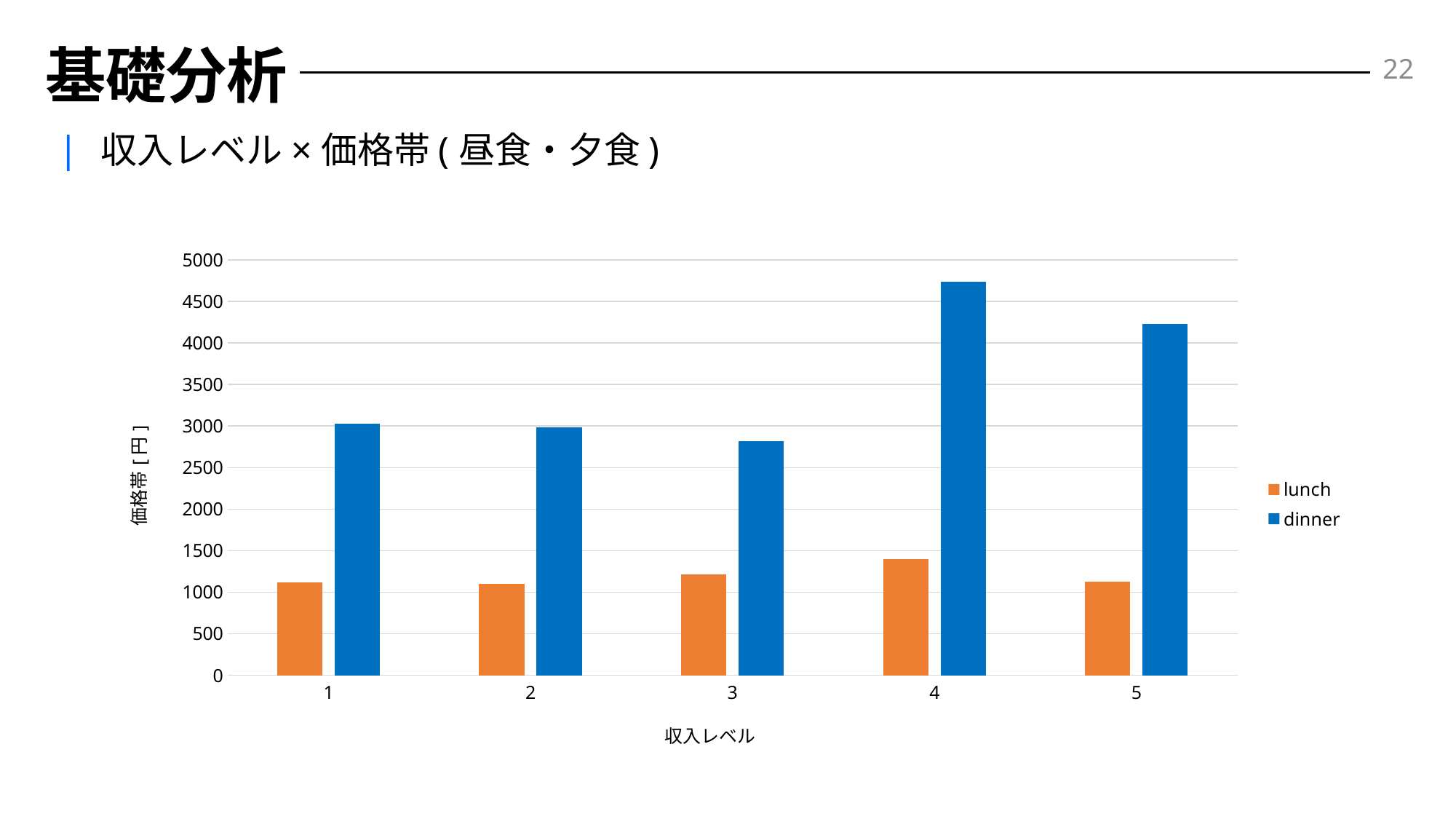
Is the dinner value for income level 4 greater or less than 4500? greater Which income level has the lowest dinner value? 3 What are the two entries in the legend? lunch, dinner Which income level has the highest dinner value? 4 Which income level has the highest lunch value? 4 Is the dinner value for income level 3 greater or less than 3000? less Which is larger, the dinner value for income level 4 or for income level 5? income level 4 How many income levels (収入レベル) are shown on the x axis? 5 At income level 1, which is larger, lunch or dinner? dinner Is the lunch value for income level 4 greater or less than 1500? less How many series does the legend list? 2 What kind of chart is shown on the slide? bar chart